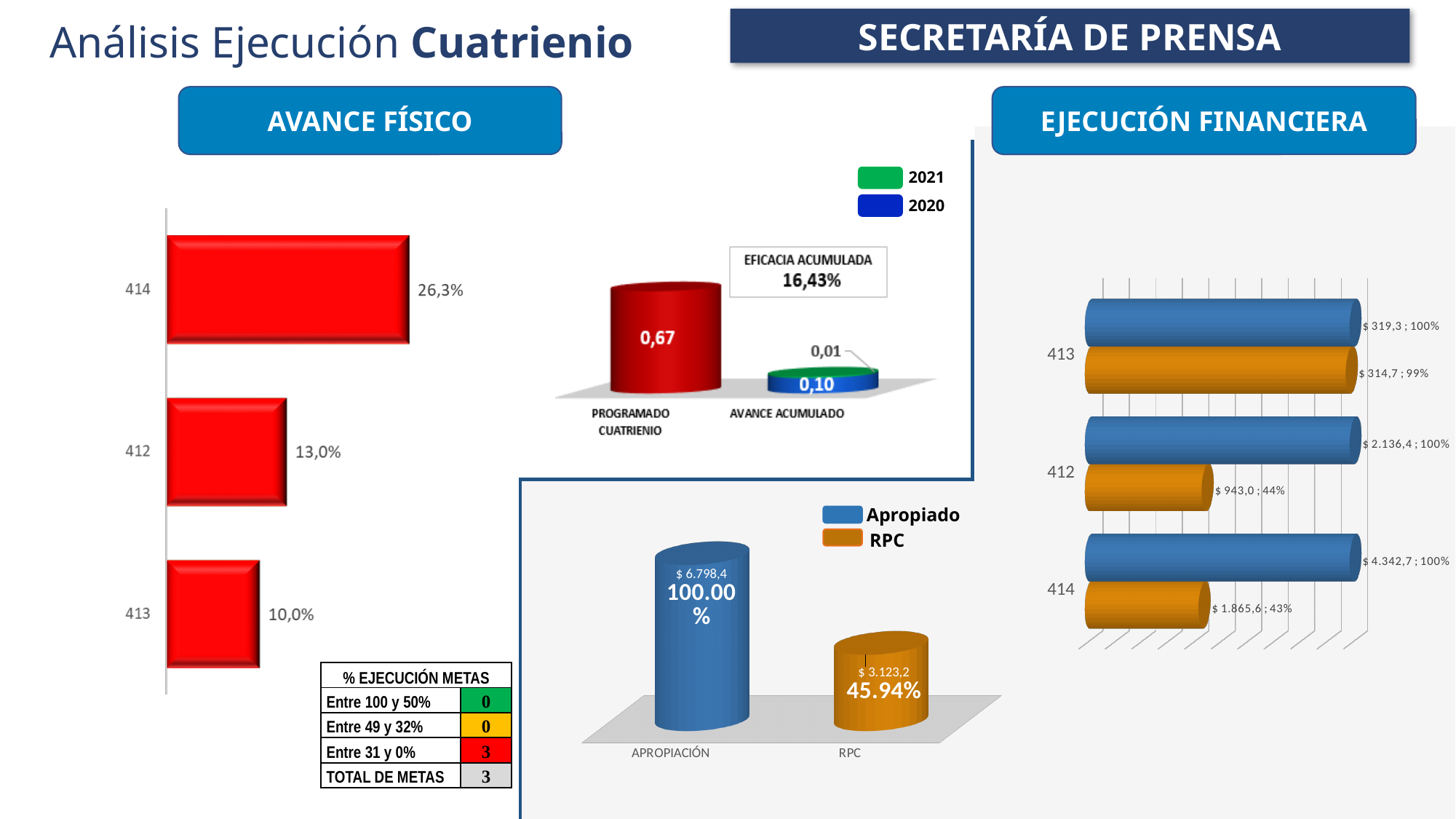
In the cylinder chart in the top middle, what is the value for PROGRAMADO CUATRIENIO? 0,67 In the bottom middle chart with APROPIACIÓN and RPC, what percentage is shown for RPC? 45.94% In the red bar chart on the left under AVANCE FÍSICO, which category has the lowest value? 413 In the cylinder chart in the top middle, how many series does the legend list? 2 In the cylinder chart in the top middle, what is the EFICACIA ACUMULADA shown? 16,43% In the EJECUCIÓN FINANCIERA chart on the right, which category has the highest Apropiado value? 414 In the red bar chart on the left under AVANCE FÍSICO, how many categories are plotted? 3 In the EJECUCIÓN FINANCIERA chart on the right, what is the RPC value for category 412? $ 943,0 ; 44% In the red bar chart on the left under AVANCE FÍSICO, what is the value for category 414? 26,3% In the red bar chart on the left under AVANCE FÍSICO, what kind of chart is it? bar chart In the red bar chart on the left under AVANCE FÍSICO, what is the difference between the values for 414 and 412? 13,3% In the bottom middle chart with APROPIACIÓN and RPC, what amount is shown for APROPIACIÓN? $ 6.798,4